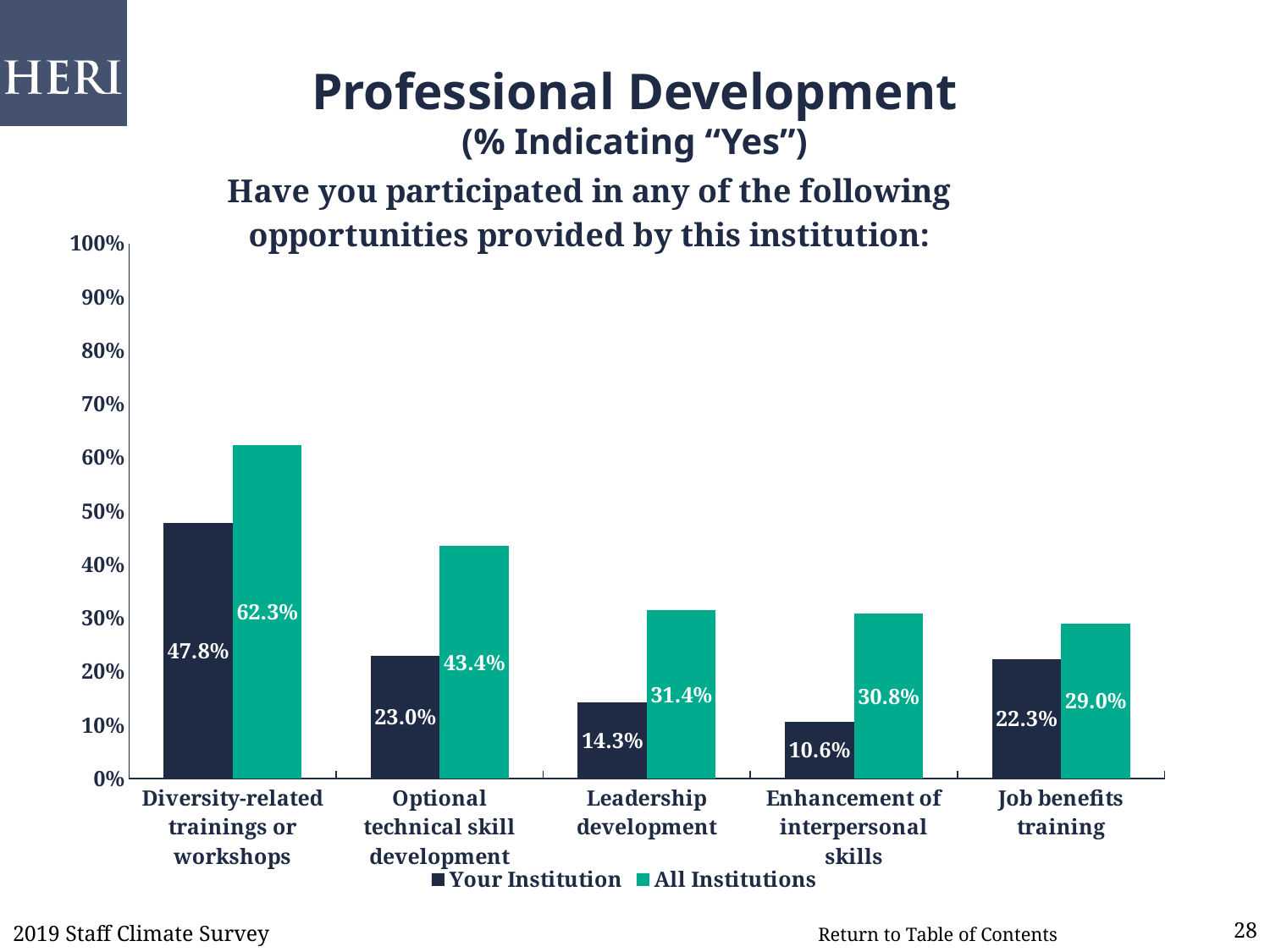
How many categories are shown on the x axis? 5 What is the difference between All Institutions and Your Institution for Optional technical skill development? 20.4% Which category has the lowest value for Your Institution? Enhancement of interpersonal skills Is the value for All Institutions for Diversity-related trainings or workshops greater or less than 60%? greater What kind of chart is shown on the slide? Bar chart What is the value for Your Institution for Diversity-related trainings or workshops? 47.8% What is the value for All Institutions for Leadership development? 31.4% Which is larger for Job benefits training: Your Institution or All Institutions? All Institutions Which category has the highest value for All Institutions? Diversity-related trainings or workshops How many series does the legend list? 2 What is the title of the chart? Have you participated in any of the following opportunities provided by this institution: What is the value for Your Institution for Enhancement of interpersonal skills? 10.6%